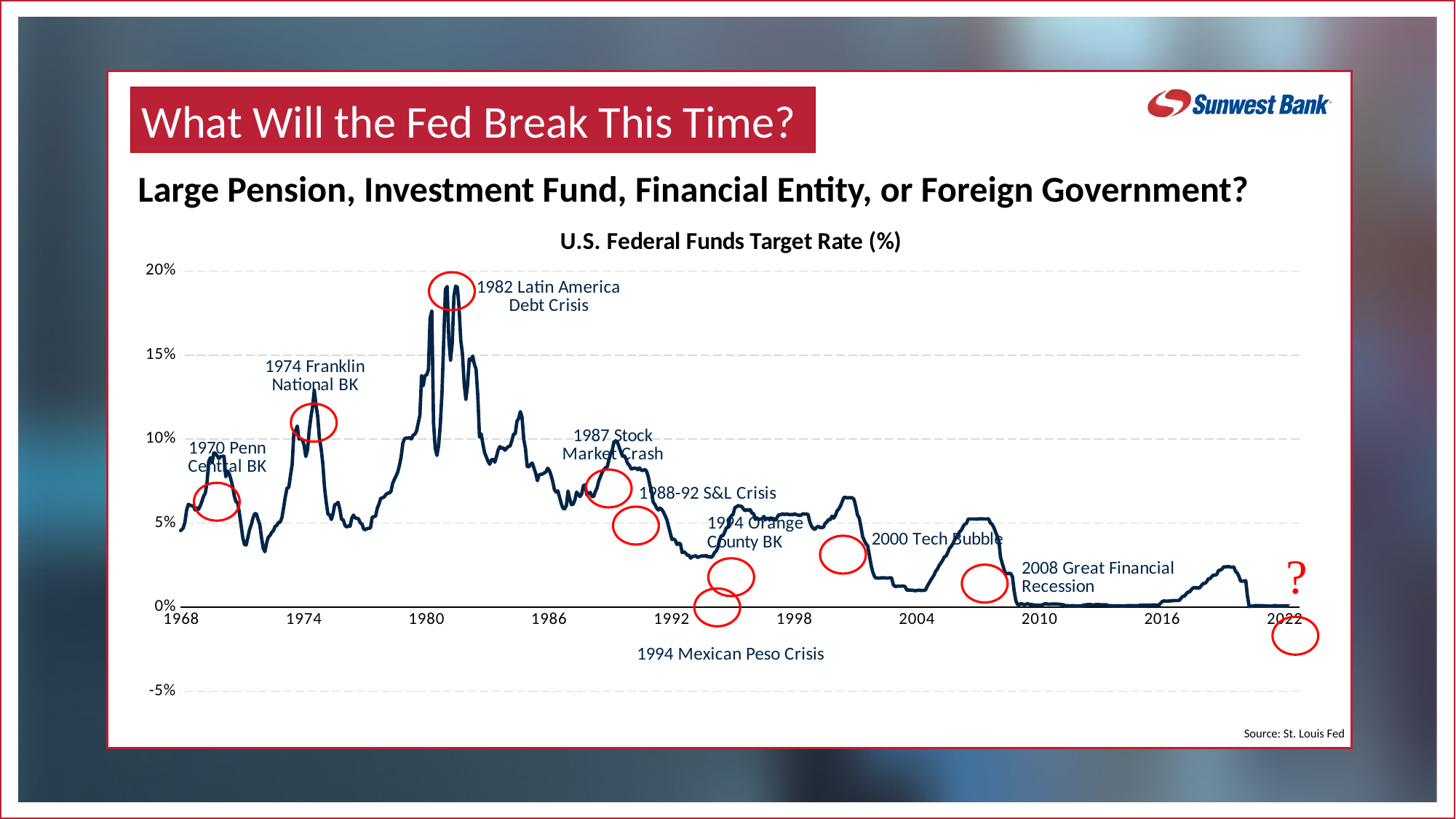
What is the title of the chart? U.S. Federal Funds Target Rate (%) How many year labels are shown on the x axis? 10 What is the last year labelled on the x axis of the chart? 2022 Which annotated event is circled at the highest point of the line? 1982 Latin America Debt Crisis What is the highest value labelled on the y axis? 20% What kind of chart is shown on the slide? Line chart Is the Federal Funds Target Rate at the 1974 Franklin National BK peak greater or less than 10%? greater Which is higher, the Federal Funds Target Rate at the 1982 Latin America Debt Crisis or at the 2000 Tech Bubble? 1982 Latin America Debt Crisis Overall, does the Federal Funds Target Rate rise or fall from its 1982 peak to 2022? Fall Is the peak of the Federal Funds Target Rate around 1982 greater or less than 15%? greater Is the Federal Funds Target Rate around 2012 greater or less than 5%? less What is the first year labelled on the x axis of the chart? 1968